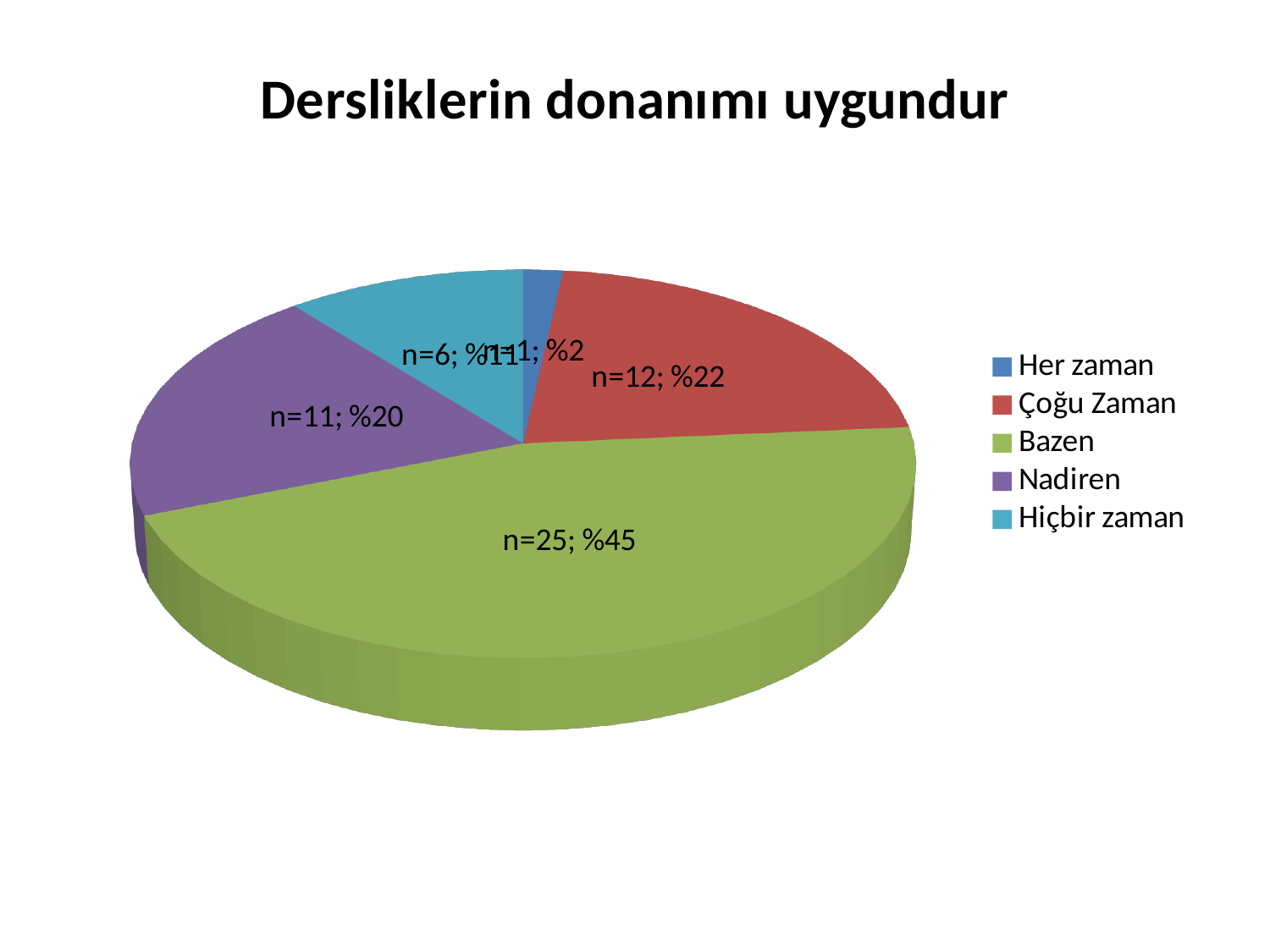
Which category has the smallest slice? Her zaman How many categories does the legend list? 5 What is the difference in n between the Bazen and Çoğu Zaman slices? 13 What is the n value for the Bazen slice? n=25 Which has a larger share, Çoğu Zaman or Nadiren? Çoğu Zaman What percentage share does the Nadiren slice have? %20 What percentage share does the Çoğu Zaman slice have? %22 What kind of chart is shown on the slide? pie chart What is the n value for the Nadiren slice? n=11 What percentage share does the Bazen slice have? %45 Which category has the largest slice? Bazen What is the title of the chart? Dersliklerin donanımı uygundur